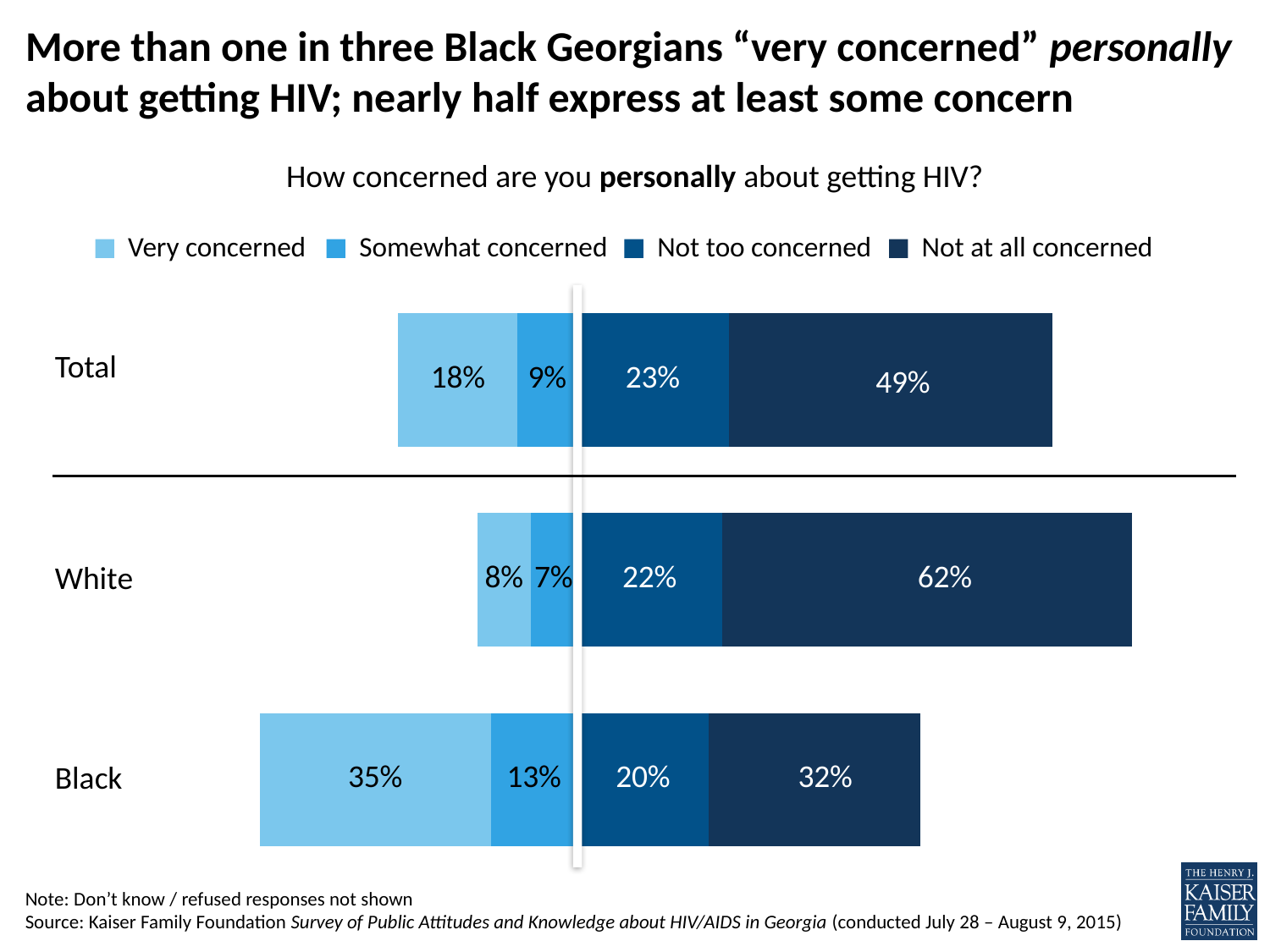
Which group has the lowest "not at all concerned" share? Black What percentage of Black respondents are "very concerned" personally about getting HIV? 35% What is the combined share of White respondents who are "very concerned" or "somewhat concerned"? 15% What percentage of White respondents are "not at all concerned"? 62% What is the difference between the "very concerned" shares for Black and White respondents? 27 percentage points Which group has the highest "very concerned" share? Black Is the "not too concerned" share larger for Total or for Black respondents? Total Which legend entry is shown in the lightest blue colour? Very concerned What is the "somewhat concerned" value for the Total group? 9% What kind of chart is shown on the slide? Stacked bar chart How many groups (bars) are shown in the chart? 3 How many series does the legend list? 4